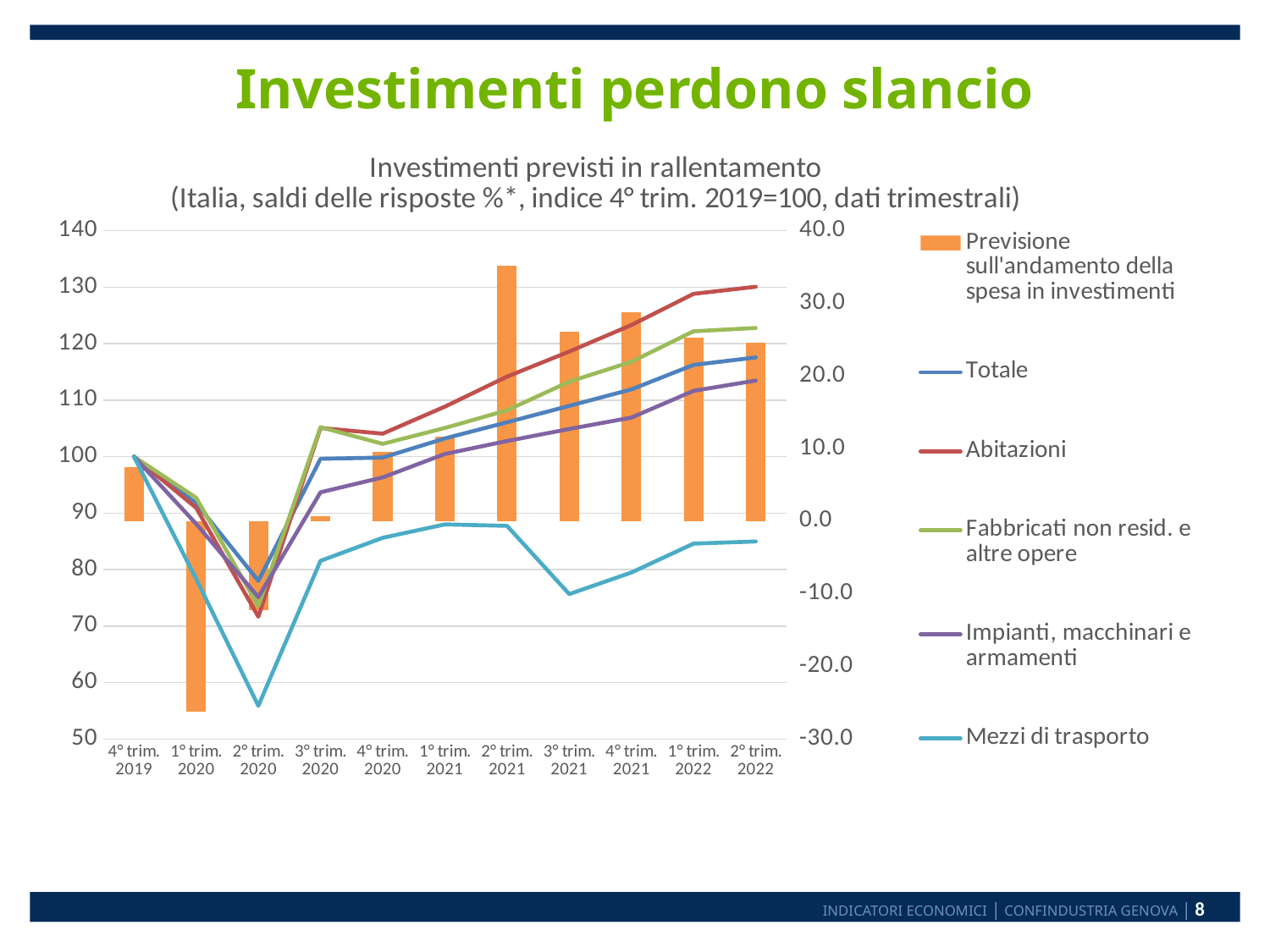
How many series does the legend list? 6 In which quarter is the Previsione sull'andamento della spesa in investimenti bar lowest? 1° trim. 2020 Which line series has the highest value in 2° trim. 2022? Abitazioni Which series is plotted as bars rather than a line? Previsione sull'andamento della spesa in investimenti What kind of chart is shown on the slide? A combined bar and line chart Is the Previsione sull'andamento della spesa in investimenti bar for 1° trim. 2020 greater or less than -20.0? less How many quarters are shown along the x axis? 11 Does the Abitazioni line rise or fall from 2° trim. 2020 to 2° trim. 2022? rise In which quarter is the Previsione sull'andamento della spesa in investimenti bar highest? 2° trim. 2021 What is the title of the chart? Investimenti previsti in rallentamento Which line series has the lowest value in 2° trim. 2020? Mezzi di trasporto Is the value for Abitazioni in 2° trim. 2022 greater or less than 120? greater